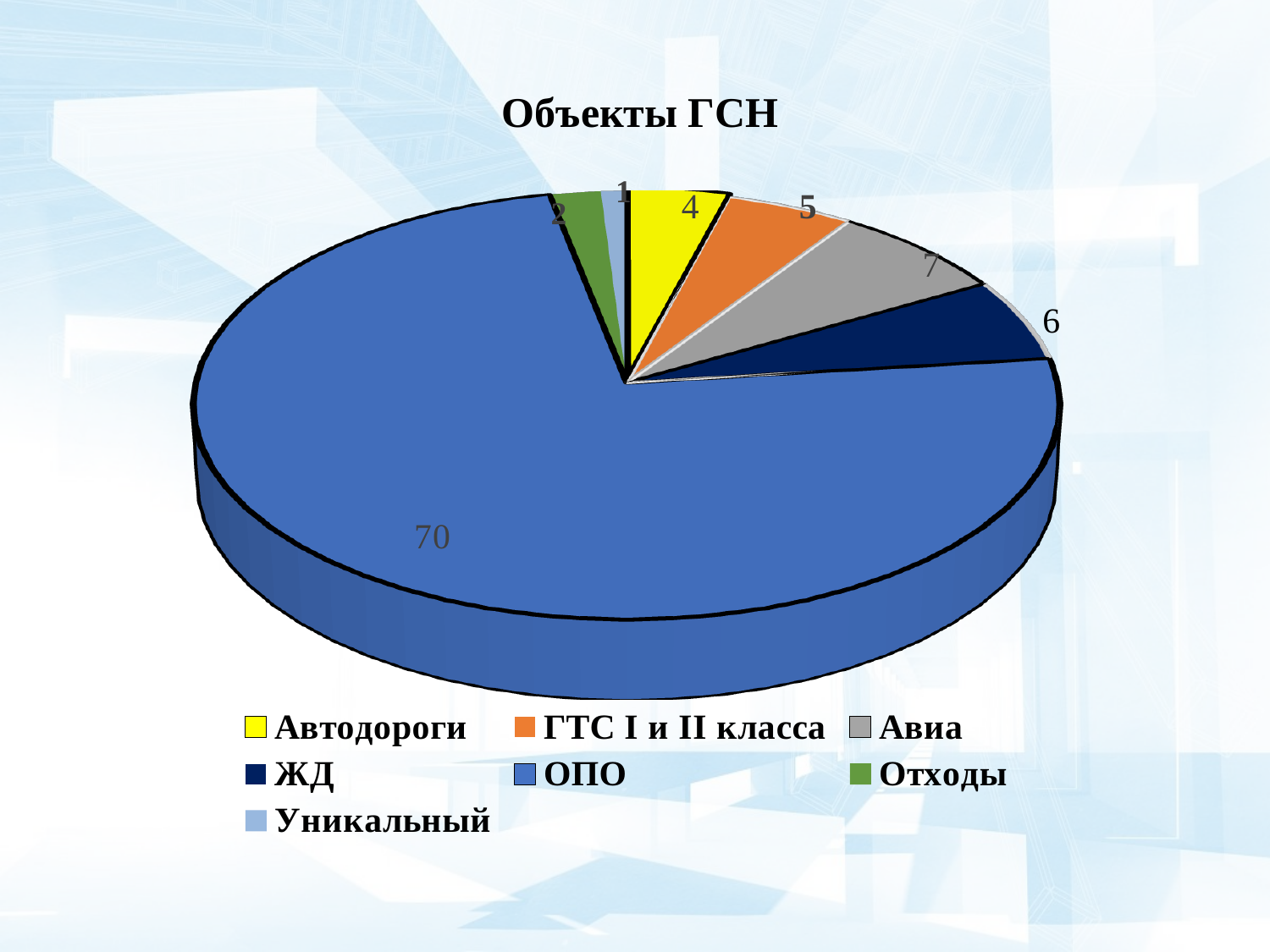
Which category has the smallest slice? Уникальный What is the value for Авиа? 7 How many categories does the legend list? 7 What is the title of the chart? Объекты ГСН What is the value for Автодороги? 4 What is the value for ОПО? 70 What kind of chart is shown on the slide? Pie chart What colour is the slice for Отходы? Green What is the difference between the values for ОПО and Авиа? 63 Which category has the largest slice? ОПО Which is larger, the value for ГТС I и II класса or the value for Отходы? ГТС I и II класса What is the value for ЖД? 6